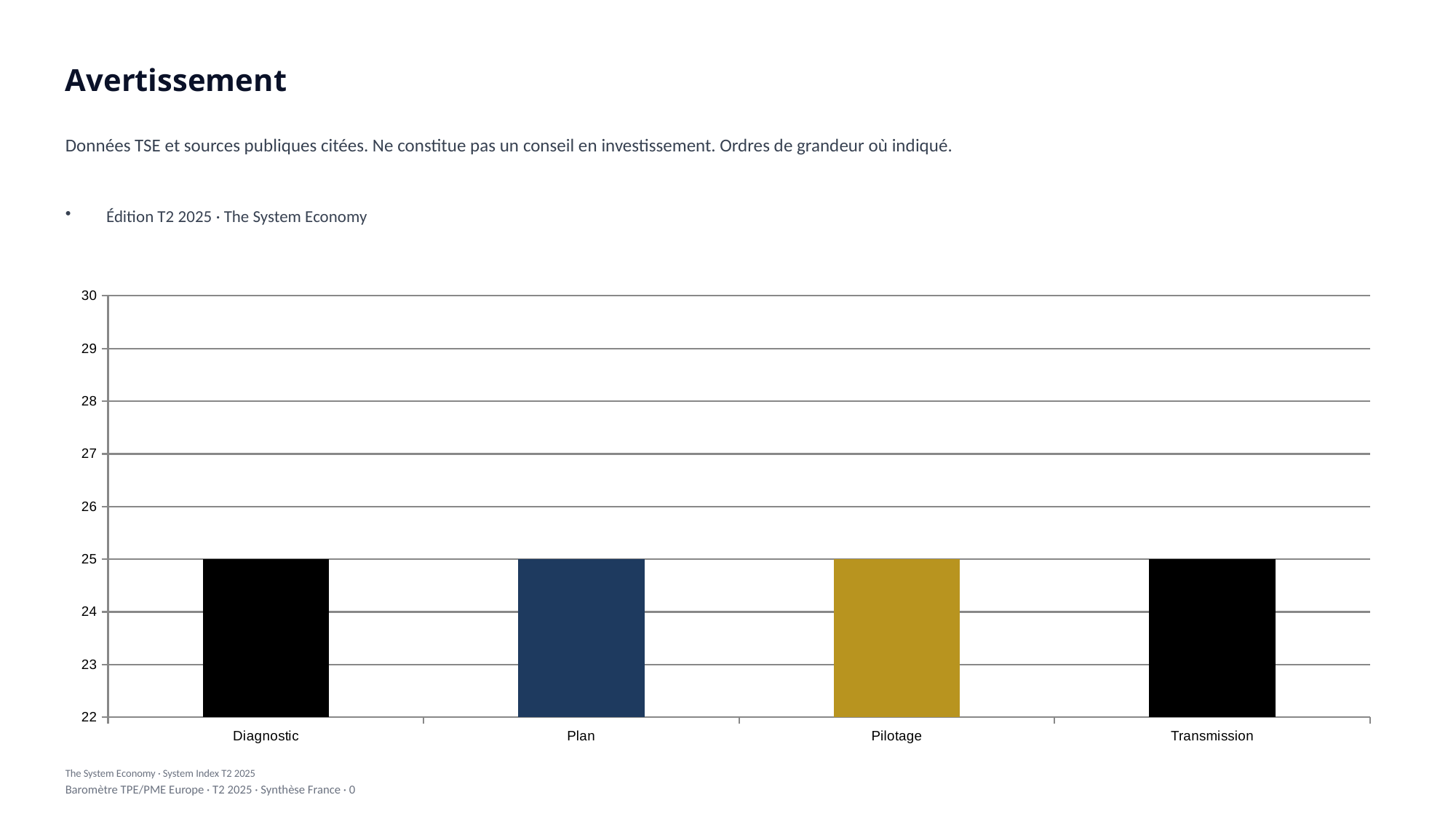
What kind of chart is shown on the slide? bar chart What is the value for Plan? 25 What is the value for Pilotage? 25 What is the value for Diagnostic? 25 What is the highest value shown on the vertical axis? 30 What is the value for Transmission? 25 What colour is the bar for Pilotage? gold Is the value for Plan greater or less than 24? greater What is the difference between the values for Diagnostic and Pilotage? 0 Do the values rise, fall, or stay flat from Diagnostic to Transmission? stay flat Is the value for Transmission greater or less than 26? less How many categories are shown on the x axis? 4